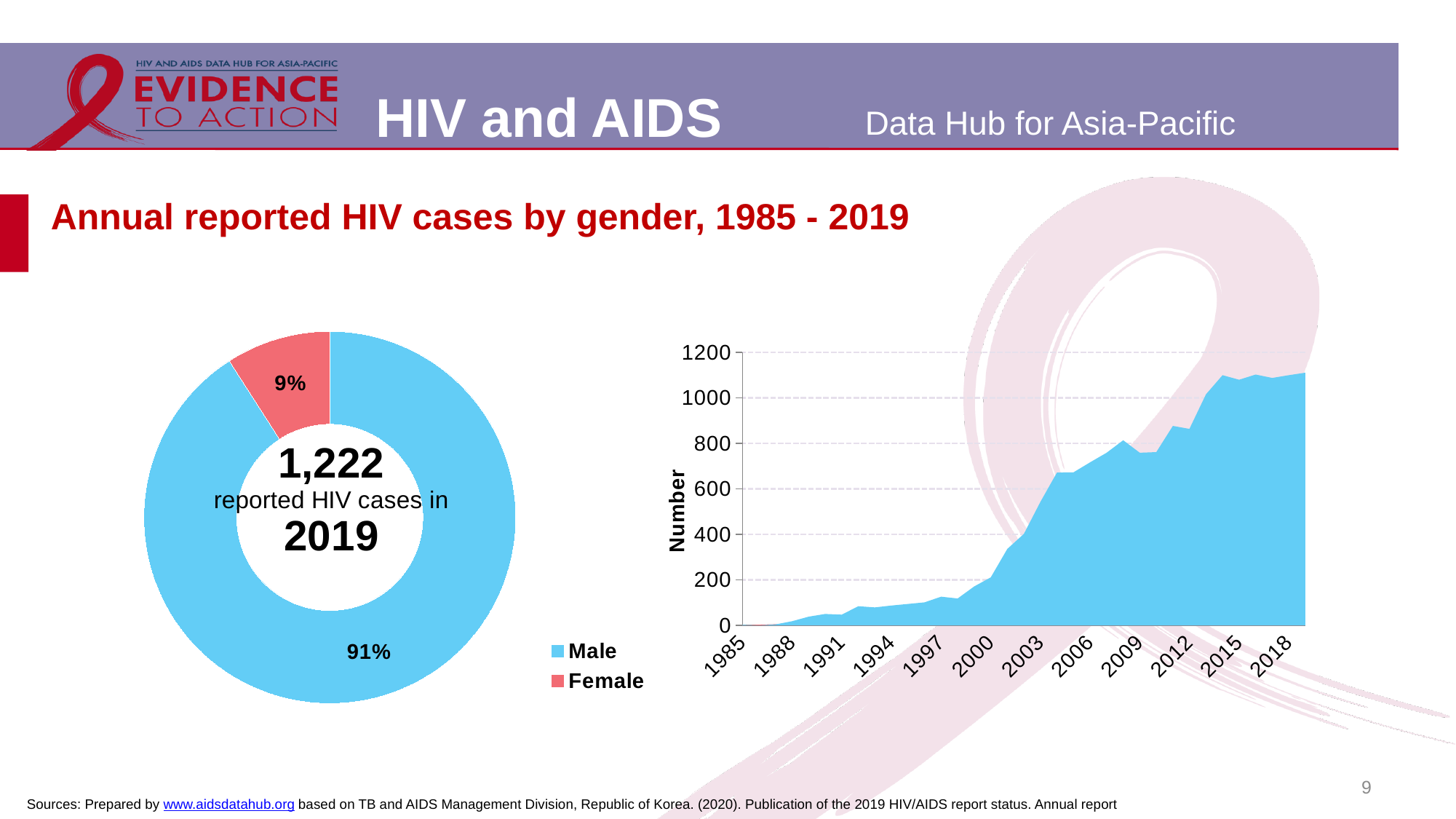
On the area chart on the right, is the value for 2000 greater or less than 400? less What kind of chart is the chart on the left of the slide? Pie (donut) chart On the area chart on the right, what is the label of the vertical axis? Number On the donut chart on the left, what share of reported HIV cases in 2019 were male? 91% On the area chart on the right, is the value for 1994 greater or less than 200? less What kind of chart is the chart on the right of the slide? Area chart On the donut chart on the left, how many reported HIV cases were there in 2019 in total? 1,222 On the donut chart on the left, which gender has the larger share of reported HIV cases? Male How many series does the legend list? 2 On the area chart on the right, do the reported HIV cases generally rise or fall from 1985 to 2018? Rise On the area chart on the right, is the value for 2018 greater or less than 1000? greater On the donut chart on the left, what share of reported HIV cases in 2019 were female? 9%